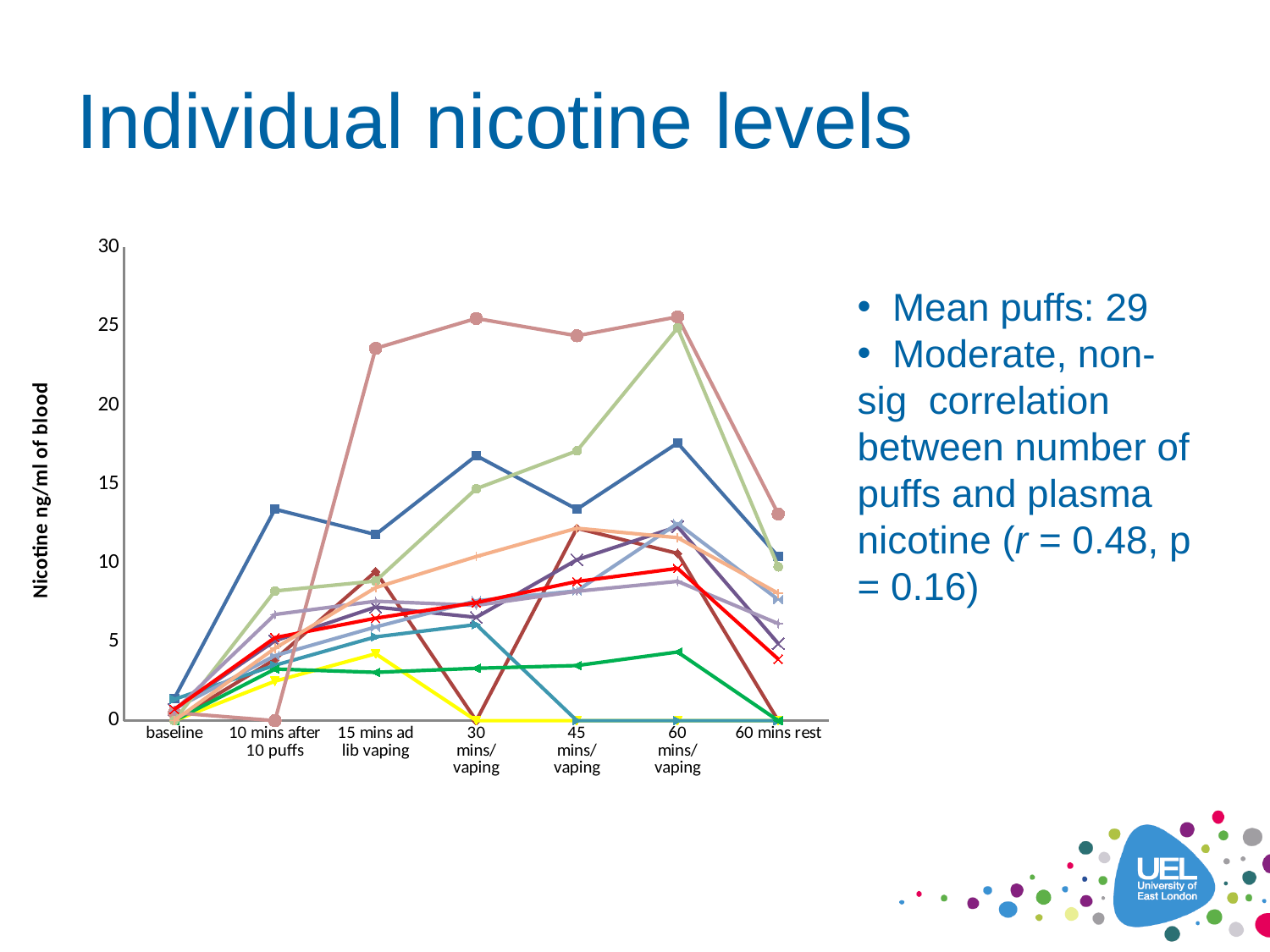
Is the value of the pink line at 15 mins ad lib vaping greater or less than 20? greater Is the value of the yellow line at 45 mins/vaping greater or less than 5? less Does the pink line rise or fall between 60 mins/vaping and 60 mins rest? fall What is the highest tick value shown on the chart's y axis? 30 Is the value of the dark blue line at 10 mins after 10 puffs greater or less than 10? greater Does the dark blue line rise or fall between baseline and 10 mins after 10 puffs? rise How many time-point categories are shown on the x axis of the chart? 7 What is the title of the chart's y axis? Nicotine ng/ml of blood What kind of chart is shown on the slide? line chart At 15 mins ad lib vaping, which line is higher: the pink line or the dark blue line? the pink line